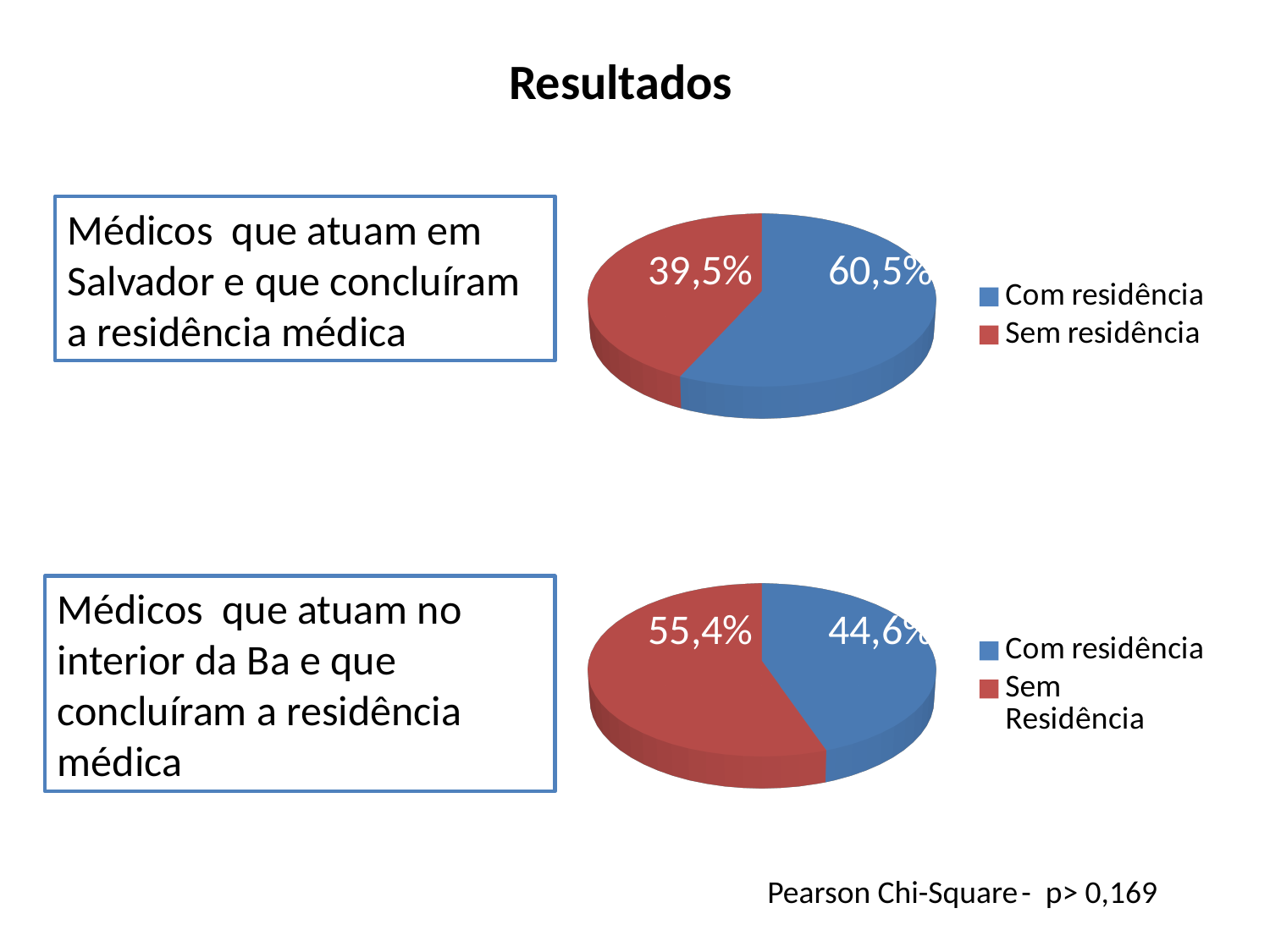
In the top pie chart (Salvador), which slice is the largest? Com residência Is the Com residência share larger in the top pie chart (Salvador) or in the bottom pie chart (interior da Ba)? Top pie chart (Salvador) In the top pie chart (Salvador), what percentage is shown for Sem residência? 39,5% How many slices does the bottom pie chart (interior da Ba) have? 2 In the bottom pie chart (interior da Ba), what is the difference between the Sem Residência and Com residência percentages? 10,8 percentage points In the top pie chart (Salvador), what percentage is shown for Com residência? 60,5% In the top pie chart (Salvador), what is the difference between the Com residência and Sem residência percentages? 21 percentage points In the bottom pie chart (interior da Ba), what percentage is shown for Com residência? 44,6% In the top pie chart (Salvador), what colour is the Sem residência slice? Red What type of chart is used for the top chart (Salvador)? Pie chart In the bottom pie chart (interior da Ba), which slice is the smallest? Com residência In the bottom pie chart (interior da Ba), what percentage is shown for Sem Residência? 55,4%